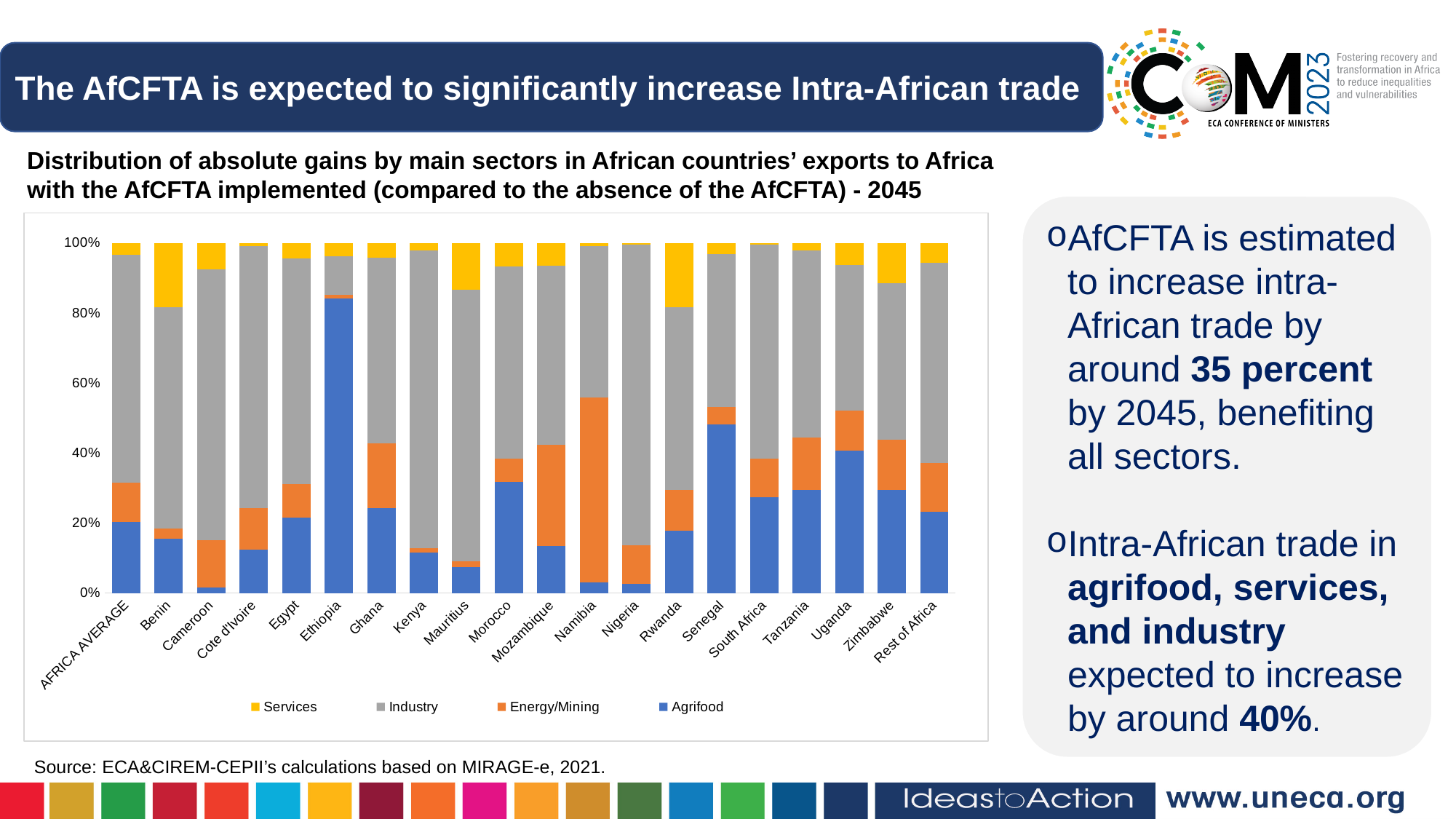
Which country has the largest Agrifood share in the chart? Ethiopia Which country has the largest Energy/Mining share in the chart? Namibia Which has the larger Energy/Mining share, Namibia or Kenya? Namibia What kind of chart is shown on the slide? Stacked bar chart How many series does the chart legend list? 4 How many countries/categories are shown along the x axis of the chart? 20 Is the Agrifood share for Ethiopia greater or less than 80%? greater Is the Agrifood share for Senegal greater or less than 40%? greater What colour represents the Services series in the chart? Yellow Is the Agrifood share for Namibia greater or less than 20%? less Which has the larger Agrifood share, Senegal or Benin? Senegal Which series are listed in the chart legend? Services, Industry, Energy/Mining, Agrifood